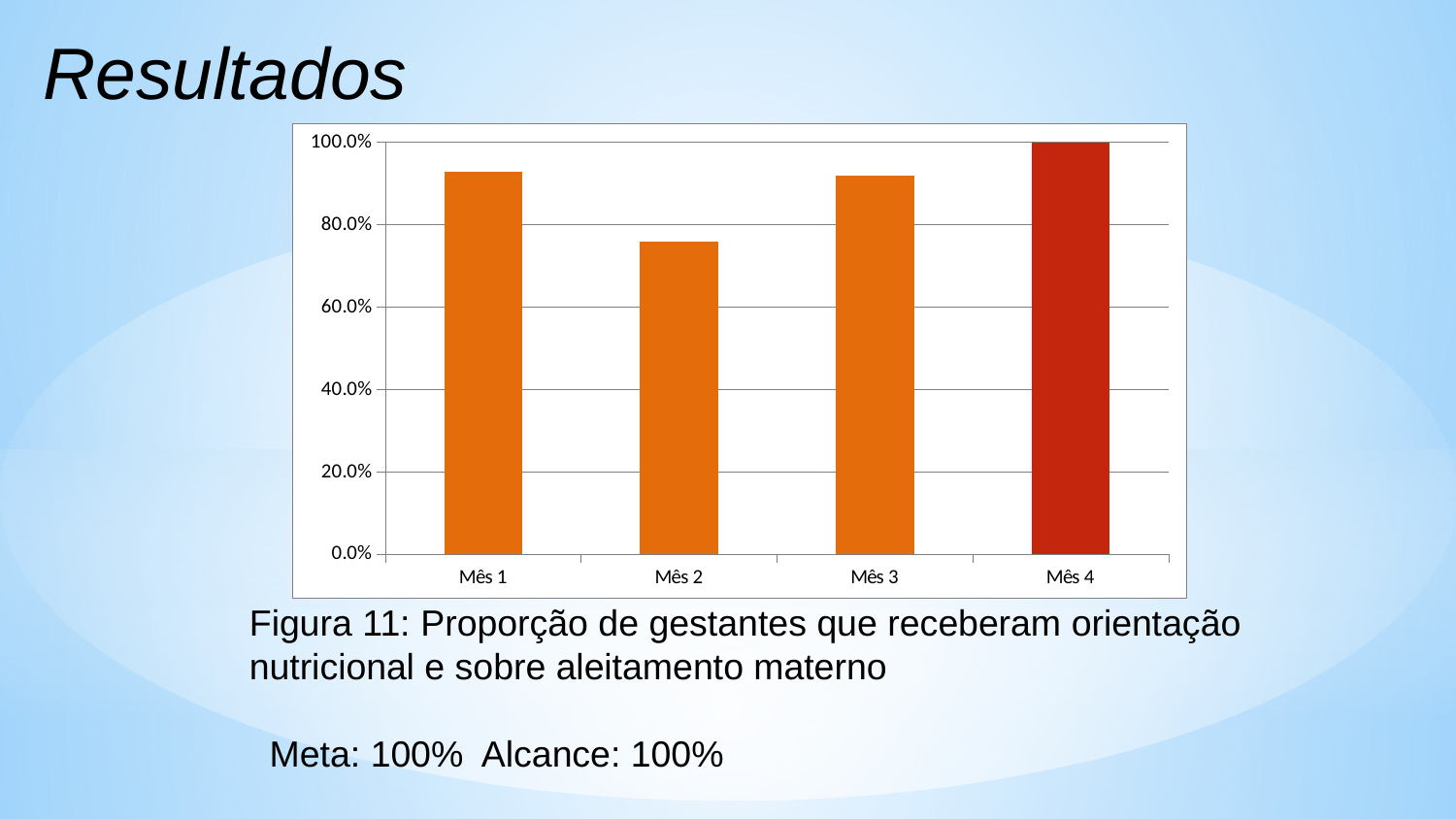
Which is larger, the value for Mês 1 or the value for Mês 2? Mês 1 Which month has the highest value on the chart? Mês 4 Which is larger, the value for Mês 4 or the value for Mês 3? Mês 4 Is the value for Mês 1 greater or less than 80.0%? greater Which month has the lowest value on the chart? Mês 2 Which month's bar is shown in a different (darker red) colour from the others? Mês 4 What kind of chart is shown on the slide? bar chart What is the value for Mês 4? 100.0% Is the value for Mês 3 greater or less than 80.0%? greater How many categories (months) are plotted on the chart? 4 Is the value for Mês 2 greater or less than 80.0%? less What figure number is given in the caption below the chart? Figura 11